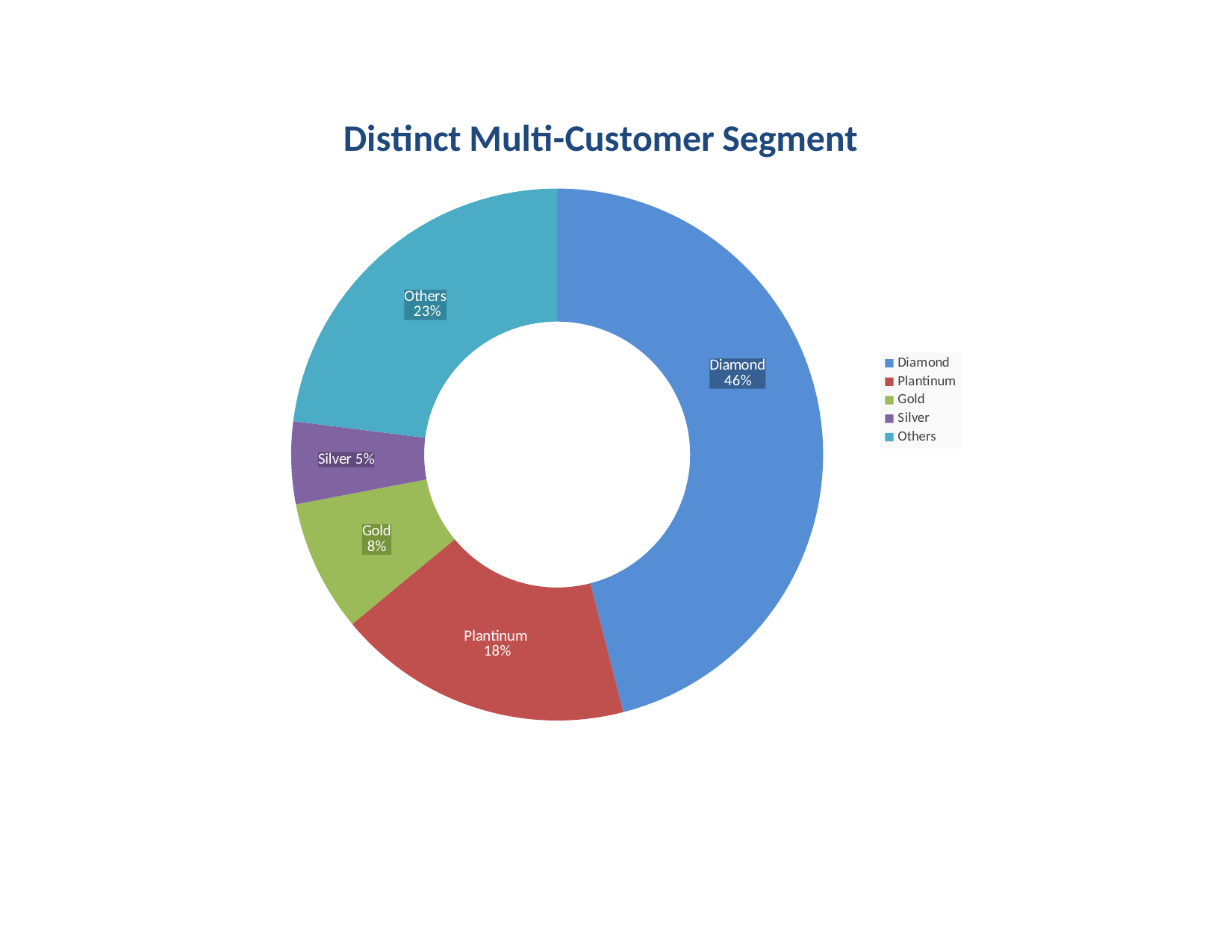
Which segment has the largest share? Diamond How many segments are shown in the chart? 5 What percentage is shown for the Silver segment? 5% What percentage is shown for the Gold segment? 8% What is the difference in percentage points between the Diamond and Others segments? 23 What percentage is shown for the Plantinum segment? 18% What kind of chart is shown on the slide? Doughnut chart What is the title of the chart? Distinct Multi-Customer Segment Which segment has the smallest share? Silver Which segment is larger, Plantinum or Gold? Plantinum What share of the chart does the Others segment represent? 23% What share of the chart does the Diamond segment represent? 46%